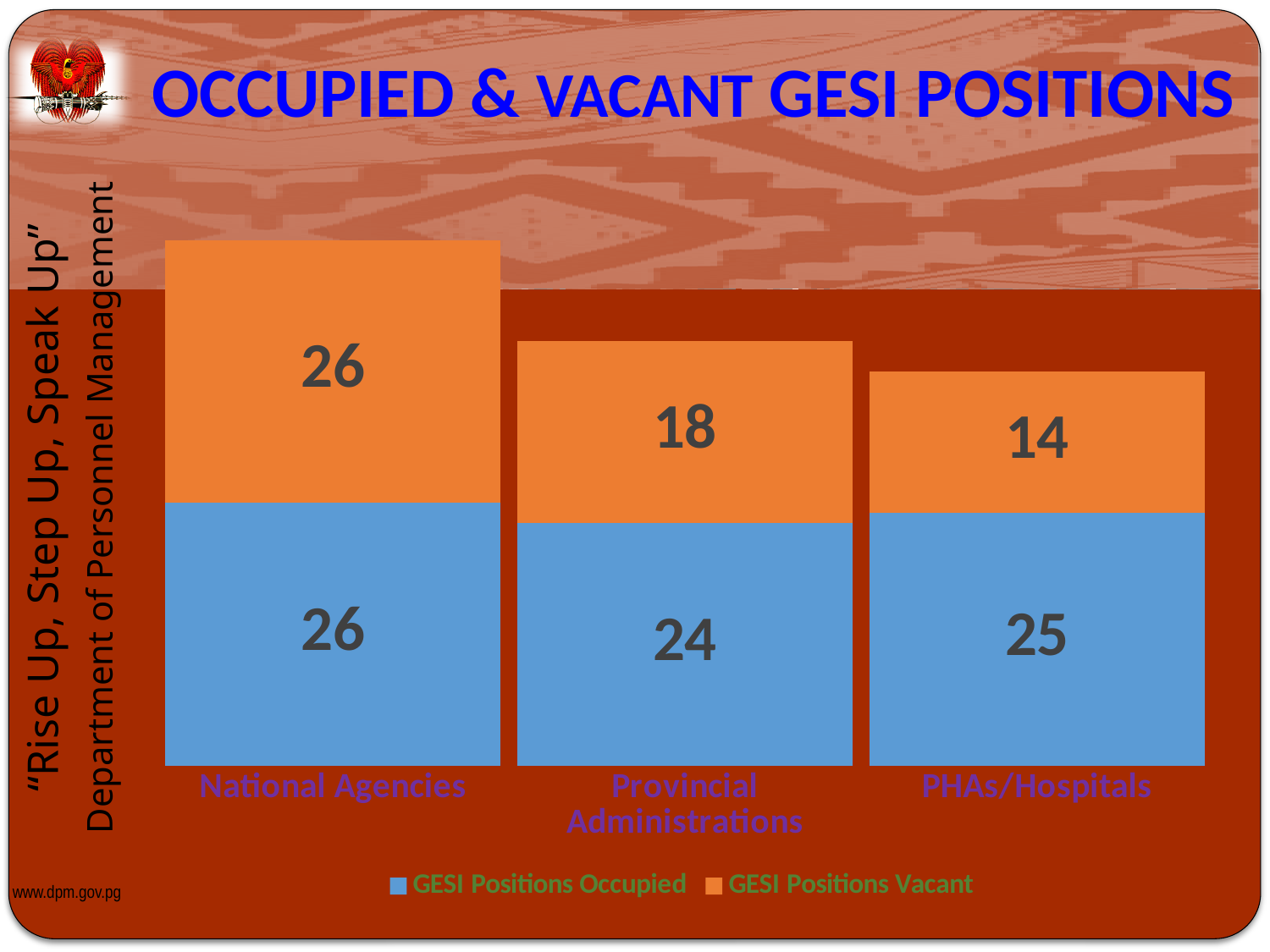
How many GESI positions are vacant in Provincial Administrations? 18 What is the difference between vacant GESI positions in National Agencies and PHAs/Hospitals? 12 Which category has the lowest number of occupied GESI positions? Provincial Administrations How many GESI positions are occupied in National Agencies? 26 How many series does the legend list? 2 Which category has the highest number of vacant GESI positions? National Agencies What kind of chart is shown on the slide? Stacked bar chart What is the total number of GESI positions (occupied plus vacant) in National Agencies? 52 How many GESI positions are vacant in PHAs/Hospitals? 14 Which is larger: occupied GESI positions in PHAs/Hospitals or in Provincial Administrations? PHAs/Hospitals How many categories are shown on the x axis? 3 What is the total number of GESI positions (occupied plus vacant) in Provincial Administrations? 42